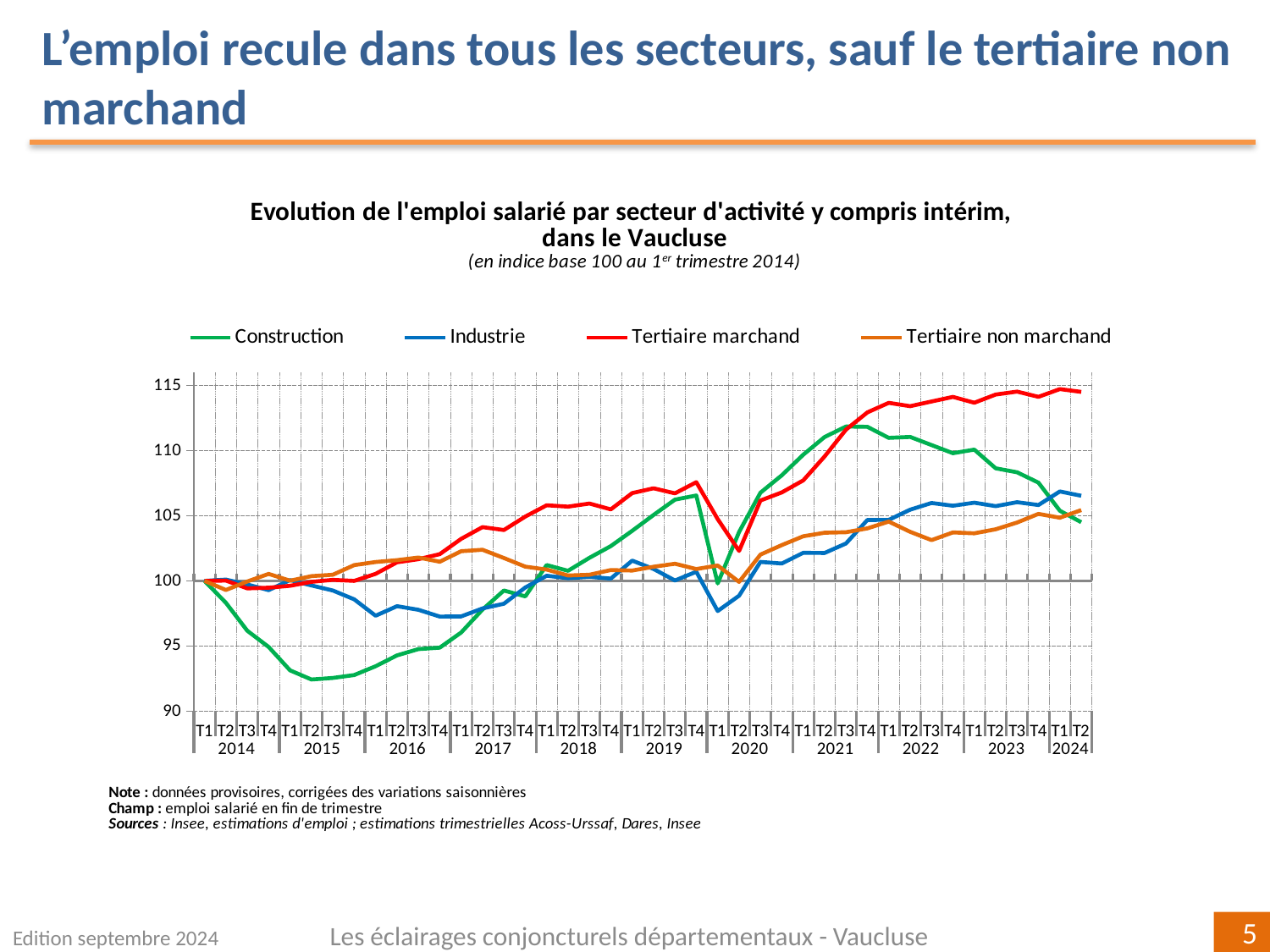
What is the index value of every series at T1 2014? 100 Does the Construction series rise or fall between T4 2021 and T2 2024? fall What kind of chart is shown on the slide? line chart At T2 2024, which is larger: Industrie or Tertiaire marchand? Tertiaire marchand Which series is drawn in red? Tertiaire marchand How many years are labelled on the x axis? 11 Which series has the highest value at T2 2024? Tertiaire marchand Is the value for Industrie at T1 2020 greater or less than 100? less Which series has the lowest value at T2 2015? Construction How many series does the legend list? 4 Is the value for Construction at T2 2015 greater or less than 95? less Is the value for Tertiaire marchand at T2 2024 greater or less than 110? greater